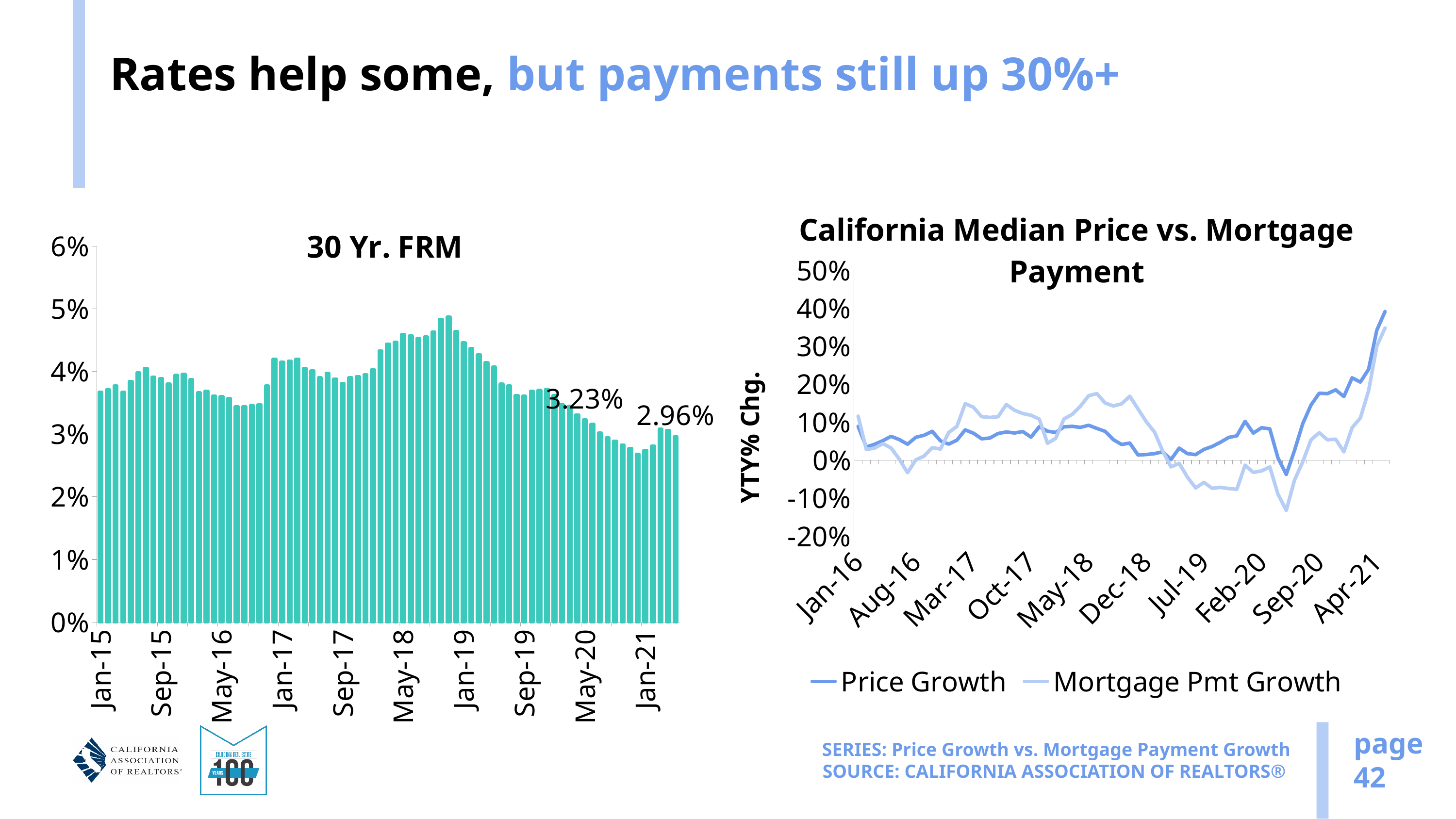
In the '30 Yr. FRM' chart, is the value for Jan-21 greater or less than 3%? less What kind of chart is the '30 Yr. FRM' chart on the left? bar chart In the '30 Yr. FRM' chart, what is the difference between the two labeled values, 3.23% and 2.96%? 0.27% How many series does the legend of the 'California Median Price vs. Mortgage Payment' chart list? 2 In the '30 Yr. FRM' chart, is the highest bar greater or less than 4%? greater In the '30 Yr. FRM' chart, do the rates rise or fall from Jan-19 to Jan-21? fall In the '30 Yr. FRM' chart, what are the two data labels printed on the chart? 3.23% and 2.96% In the 'California Median Price vs. Mortgage Payment' chart, is the Price Growth value at the end of the series (Apr-21) greater or less than 30%? greater In the '30 Yr. FRM' chart, what value is labeled on the last bar? 2.96% In the 'California Median Price vs. Mortgage Payment' chart, which series reaches the lowest value? Mortgage Pmt Growth What is the y-axis label of the 'California Median Price vs. Mortgage Payment' chart? YTY% Chg. What kind of chart is the 'California Median Price vs. Mortgage Payment' chart on the right? line chart